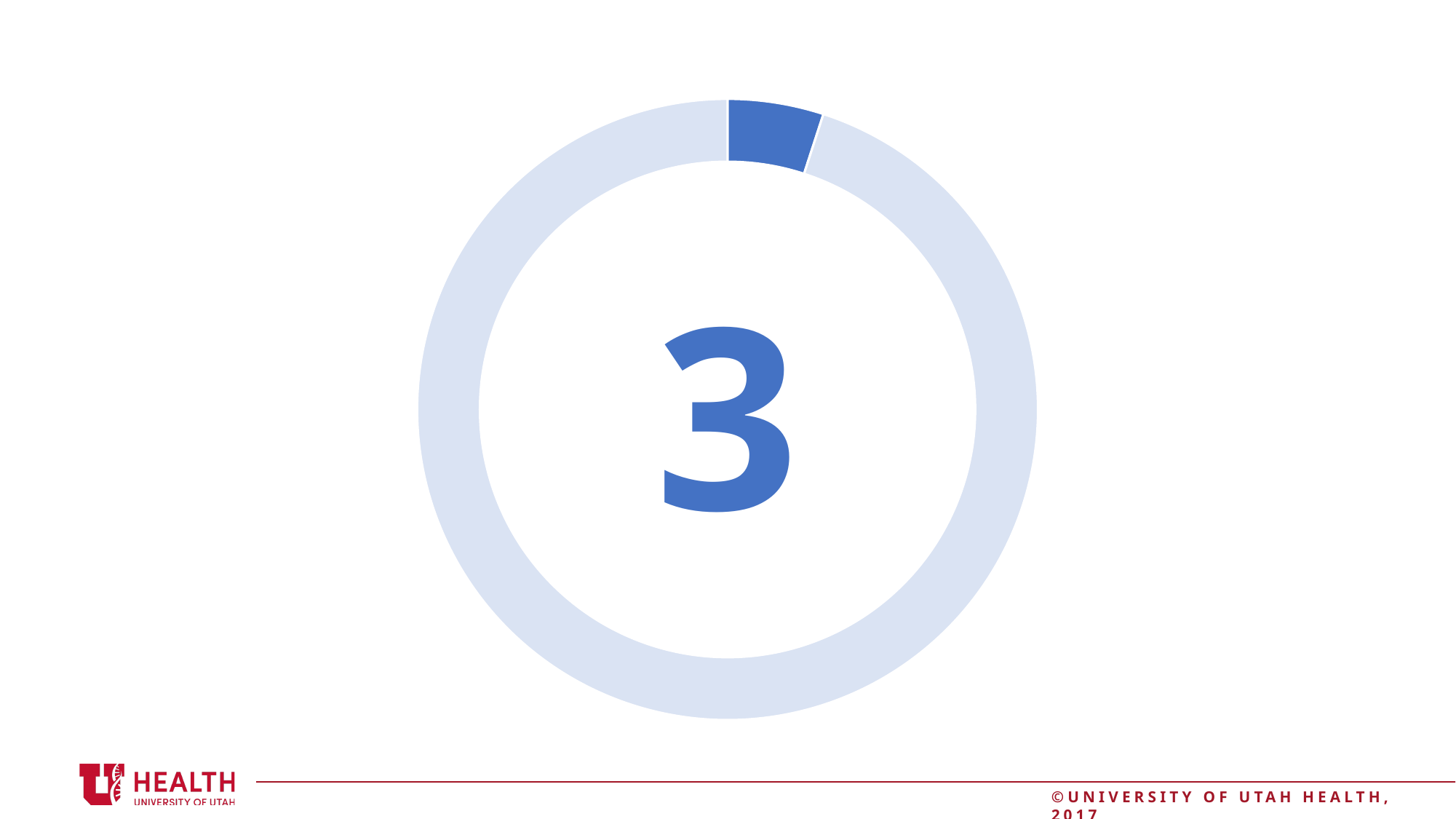
What colour is the small segment at the top of the ring? dark blue How many segments does the doughnut ring have? 2 What kind of chart is shown on the slide? doughnut chart Does the chart have a legend? No Is the dark blue segment's share of the ring greater or less than 50%? less Which segment of the doughnut is larger, the dark blue one or the light blue one? the light blue one What number is printed in the centre of the doughnut chart? 3